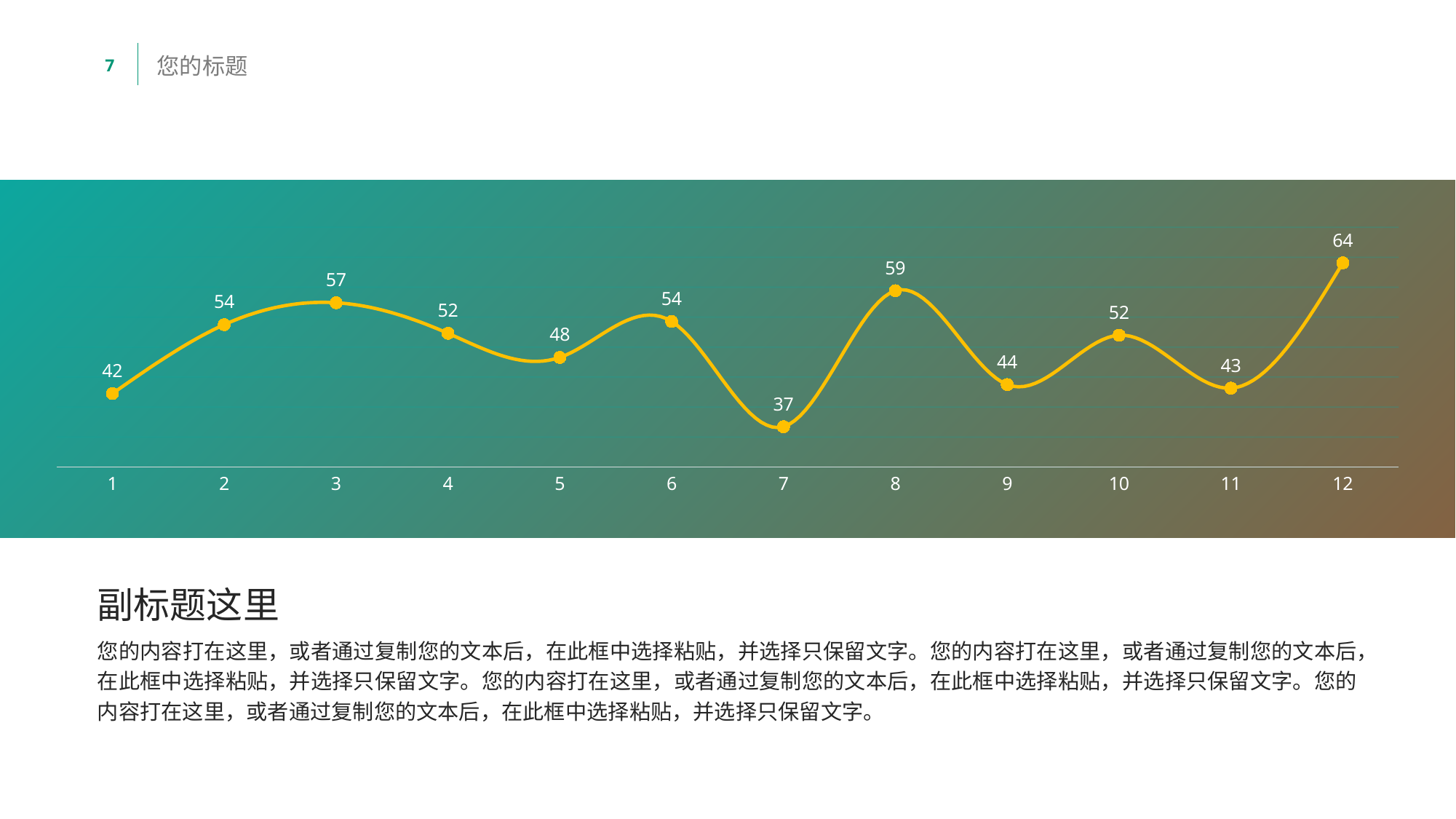
What is the difference between the values at point 8 and point 9? 15 Which has a larger value, point 2 or point 5? Point 2 Which point on the x axis has the lowest value? 7 Does the value rise or fall from point 1 to point 3? Rise Which has a larger value, point 9 or point 11? Point 9 What is the value at point 12? 64 What is the value at point 7? 37 What is the value at point 3? 57 Which point on the x axis has the highest value? 12 What is the difference between the values at point 12 and point 7? 27 How many data points are plotted on the line? 12 What kind of chart is shown on the slide? Line chart